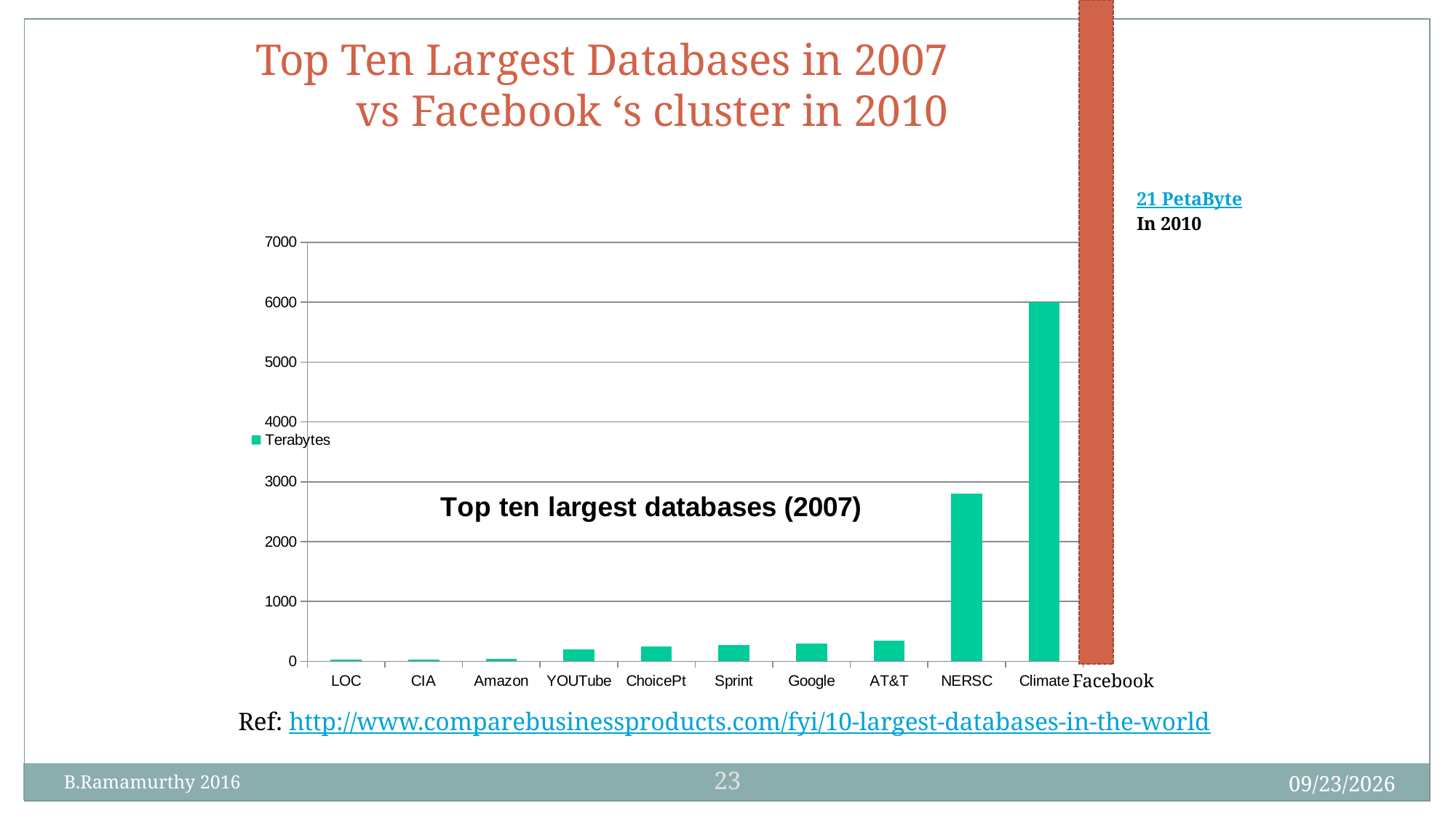
How many categories are plotted on the x axis of the chart? 10 Is the value for NERSC greater or less than 2000? greater Is the value for Climate greater or less than 5000? greater Which has a larger value, YOUTube or AT&T? AT&T Is the value for AT&T greater or less than 1000? less Which category has the highest value in the chart? Climate How many series does the chart legend list? 1 What kind of chart is shown on the slide? bar chart What is the name of the series shown in the chart legend? Terabytes Which has a larger value, NERSC or Google? NERSC What is the title printed inside the chart area? Top ten largest databases (2007)